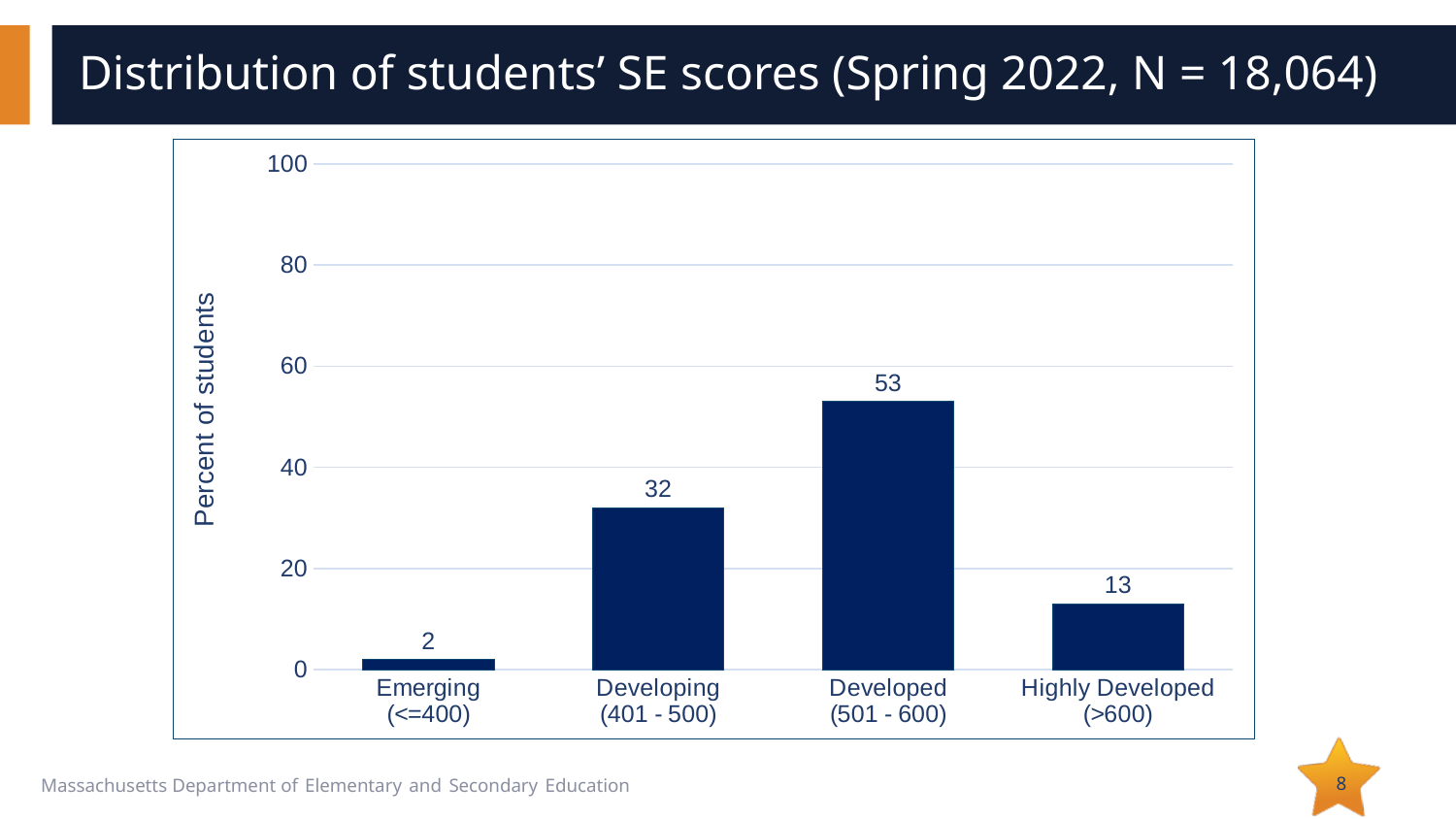
What percent of students are in the Developed (501 - 600) category? 53 Which category has a larger percent of students, Developing (401 - 500) or Highly Developed (>600)? Developing (401 - 500) What is the title of the chart? Distribution of students' SE scores (Spring 2022, N = 18,064) What kind of chart is shown on the slide? bar chart Which category has the highest percent of students? Developed (501 - 600) What is the label of the vertical axis? Percent of students What percent of students are in the Emerging (<=400) category? 2 Is the value for Developed (501 - 600) greater or less than 40? greater Which category has the lowest percent of students? Emerging (<=400) How many categories are shown on the x axis? 4 What is the difference in percent of students between the Developed and Developing categories? 21 What percent of students are in the Highly Developed (>600) category? 13